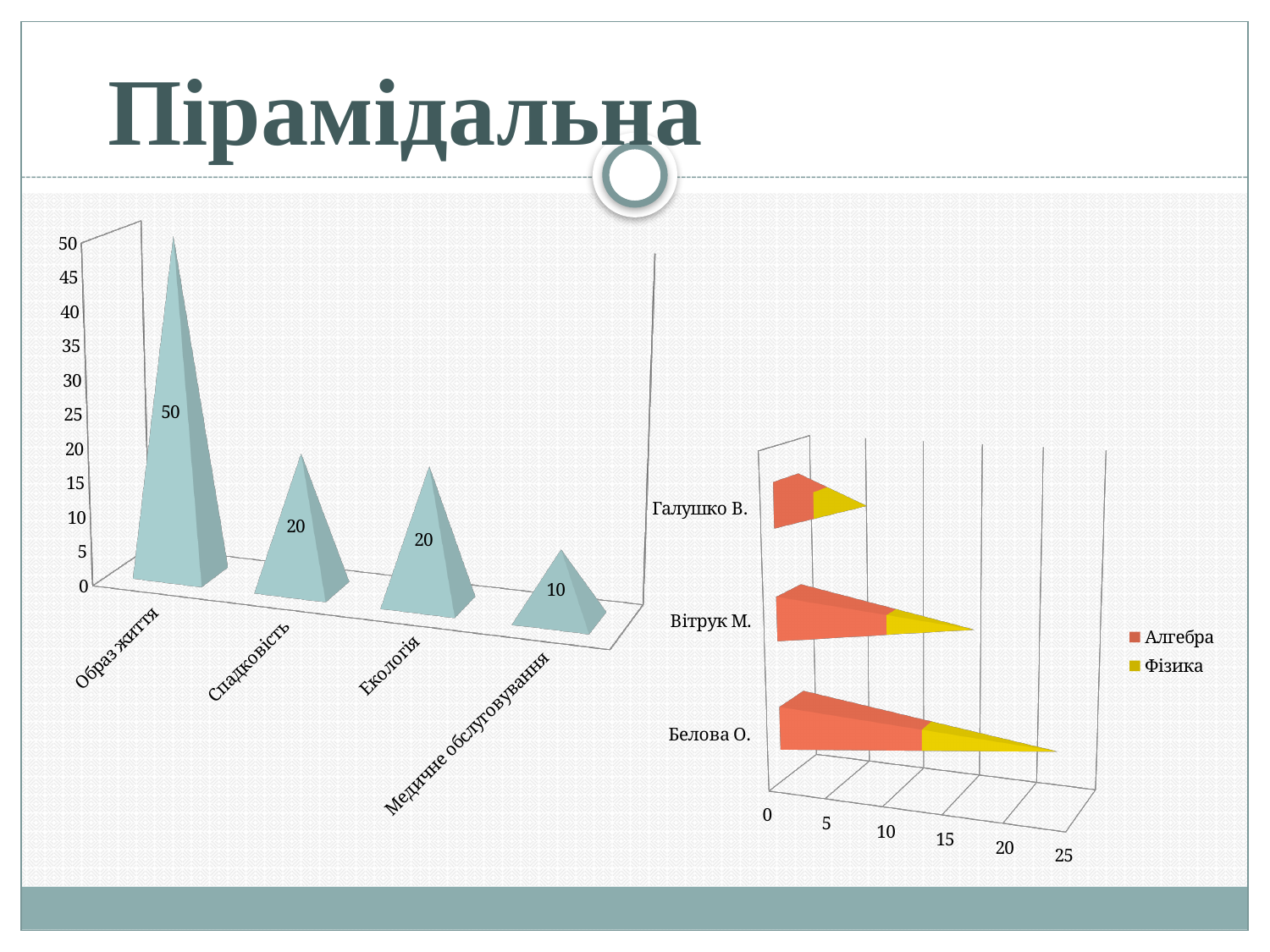
On the left chart, how many categories are shown? 4 On the right chart, which series is shown in yellow? Фізика On the left chart, which is larger: the value for Образ життя or the value for Спадковість? Образ життя On the left chart, which category has the highest value? Образ життя On the left chart, which category has the lowest value? Медичне обслуговування On the left chart, what is the value for Медичне обслуговування? 10 On the right chart, how many series does the legend list? 2 On the right chart, is the total value for Белова О. greater or less than 15? greater On the right chart, which person has the longest bar overall? Белова О. On the left chart, what is the difference between the values for Образ життя and Медичне обслуговування? 40 On the left chart, do the values generally rise or fall from left to right along the x axis? fall On the left chart, what is the value for Образ життя? 50